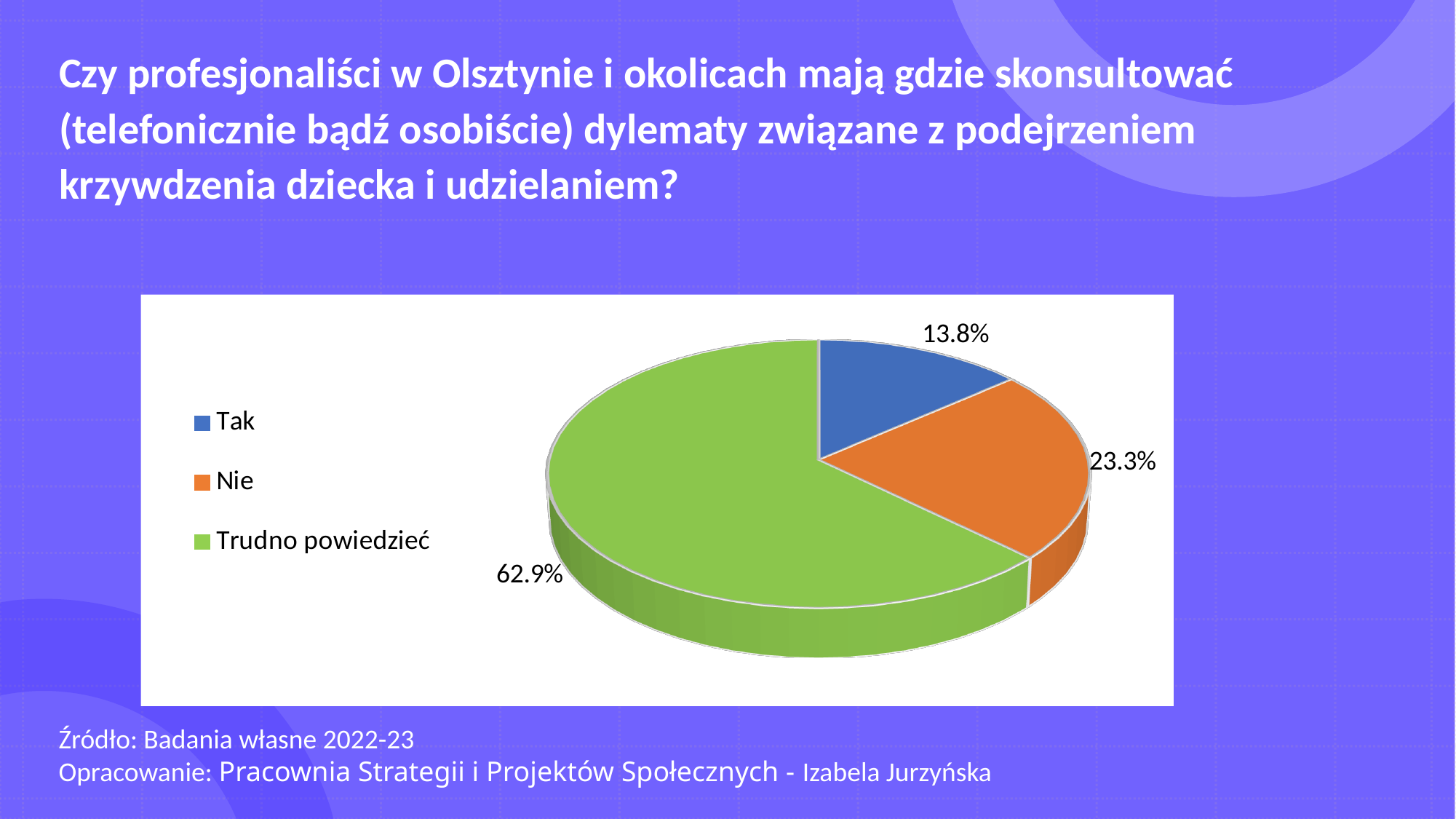
What is the difference in percentage points between "Nie" and "Tak"? 9.5 What colour is the slice for "Nie"? orange Which category has the smallest slice of the pie? Tak What is the difference in percentage points between "Trudno powiedzieć" and "Nie"? 39.6 What share of the pie does "Trudno powiedzieć" represent? 62.9% What share of the pie does "Nie" represent? 23.3% How many categories does the pie chart have? 3 What colour is the slice for "Trudno powiedzieć"? green Which category has the largest slice of the pie? Trudno powiedzieć Which is larger, the slice for "Nie" or the slice for "Tak"? Nie What kind of chart is shown on the slide? pie chart What share of the pie does "Tak" represent? 13.8%